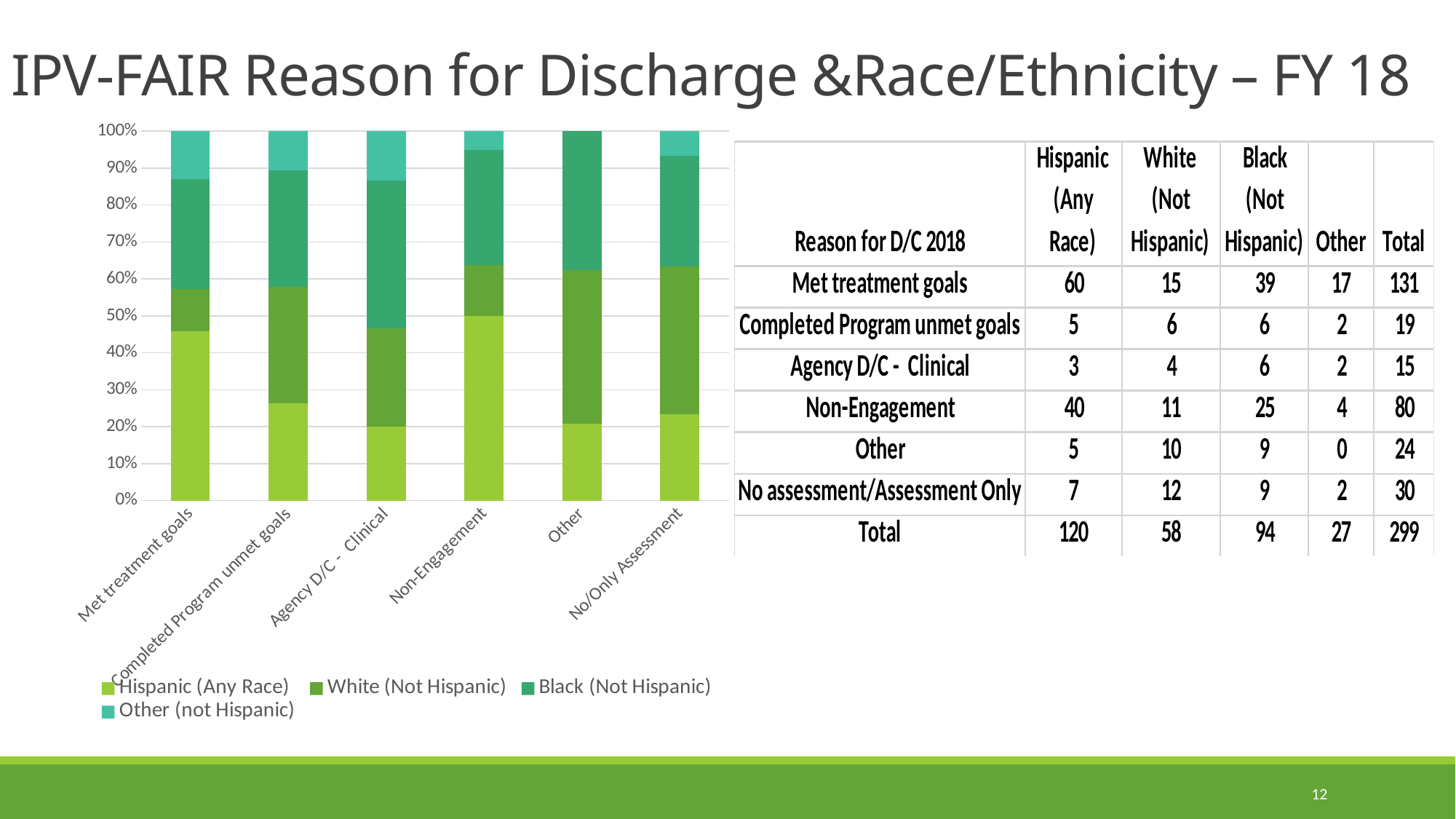
Which has a larger Hispanic (Any Race) share of its bar: Non-Engagement or Agency D/C - Clinical? Non-Engagement How many series does the chart legend list? 4 Is the Hispanic (Any Race) share of the Completed Program unmet goals bar greater or less than 30%? less Which category's bar has no Other (not Hispanic) segment? Other How many discharge reason categories are shown on the x axis of the chart? 6 Which category has the largest Hispanic (Any Race) share of its bar? Non-Engagement Which has a larger Hispanic (Any Race) share of its bar: Met treatment goals or Completed Program unmet goals? Met treatment goals What is the highest value shown on the chart's y axis? 100% Is the Hispanic (Any Race) share of the Met treatment goals bar greater or less than 40%? greater Is the Hispanic (Any Race) share of the Agency D/C - Clinical bar greater or less than 30%? less What kind of chart is shown on the slide? stacked bar chart